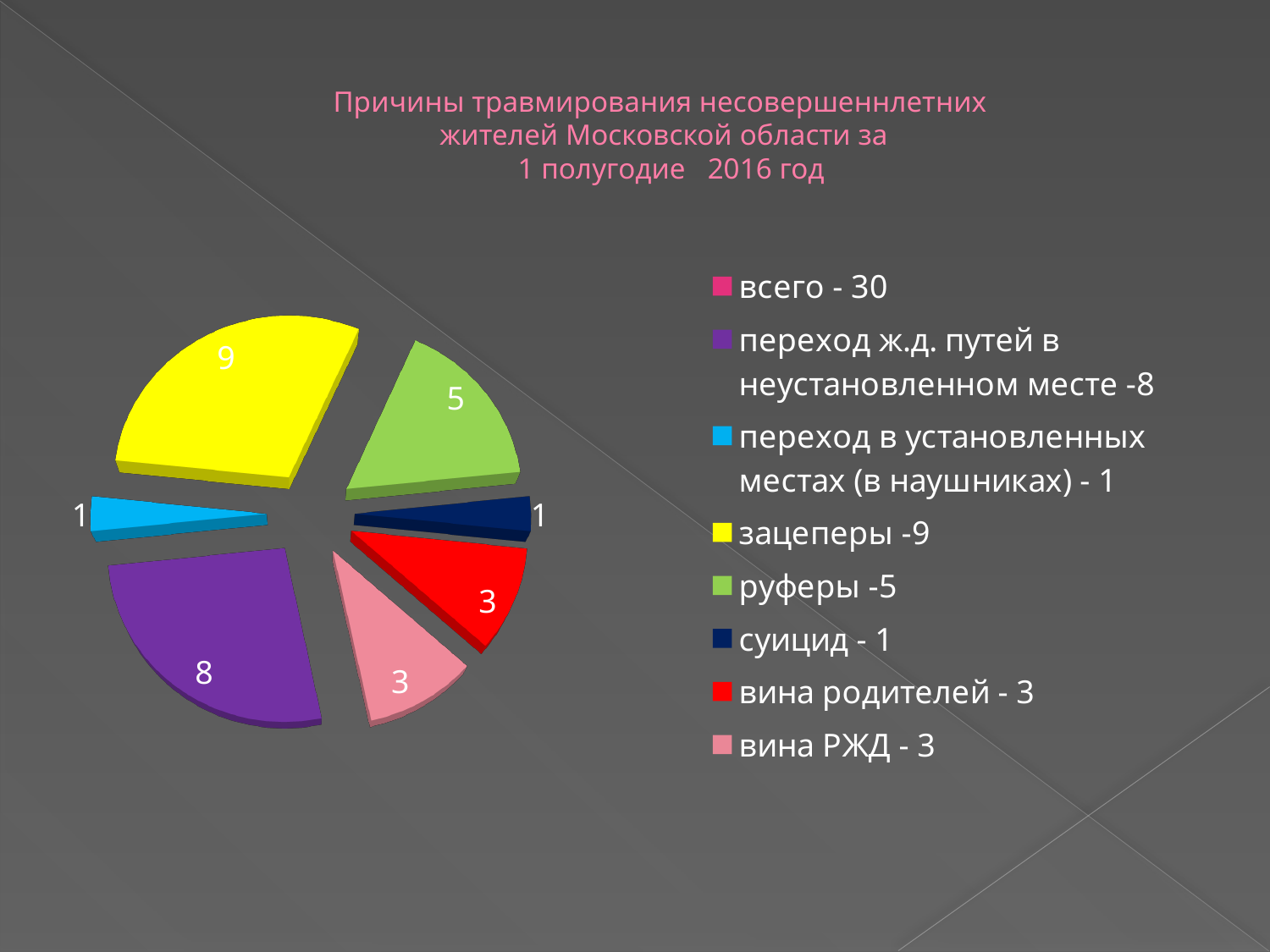
What is the value for суицид? 1 How many entries does the legend list? 8 What colour is the slice for руферы? Green What is the value for зацеперы? 9 What share of the total of 30 does зацеперы represent? 30% What is the value for переход ж.д. путей в неустановленном месте? 8 Which is larger: the value for зацеперы or the value for переход ж.д. путей в неустановленном месте? зацеперы Which category has the largest slice? зацеперы What is the value for руферы? 5 What is the value for вина РЖД? 3 What type of chart is shown on the slide? Pie chart What is the difference between the values for зацеперы and руферы? 4